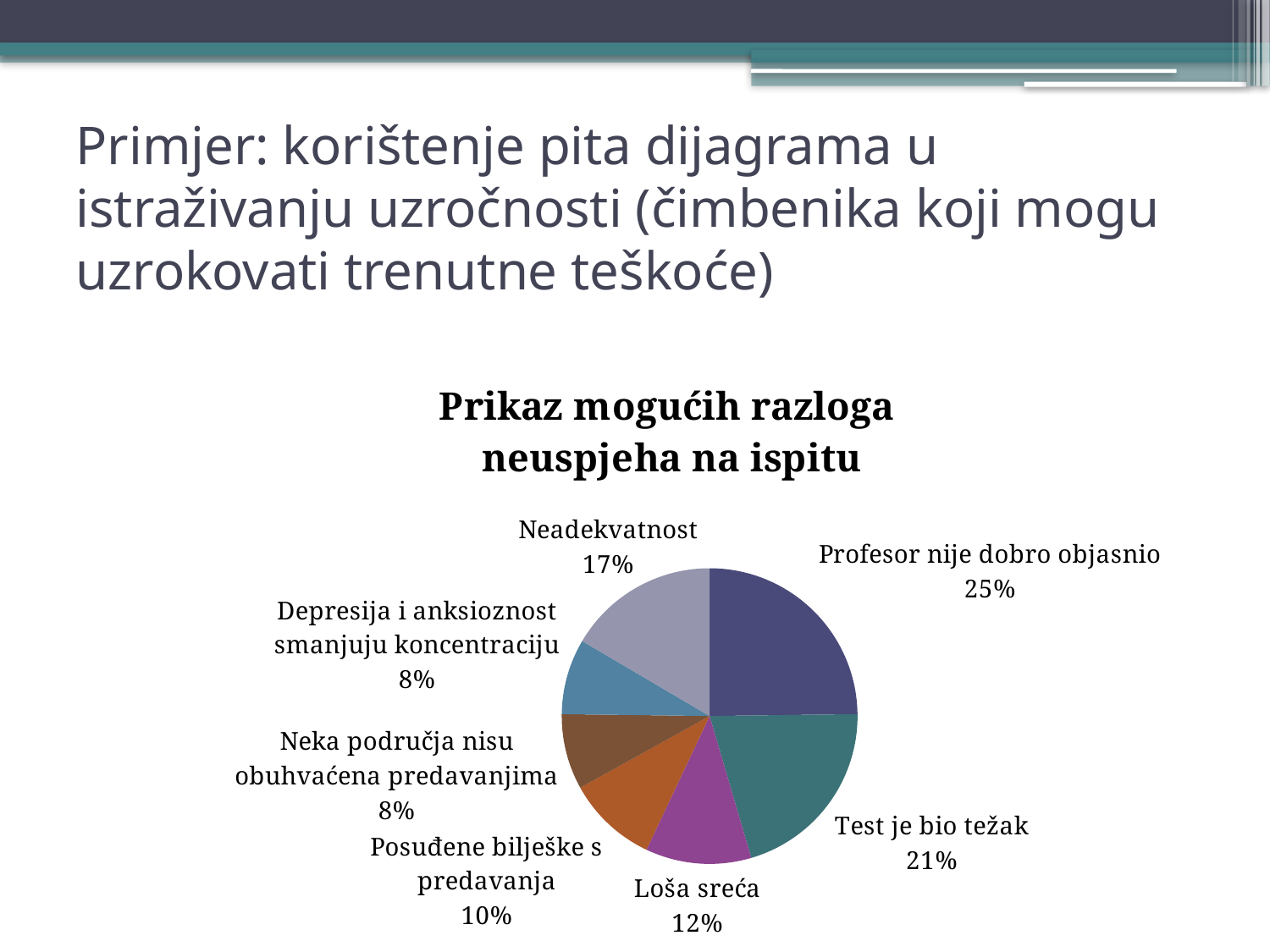
What is the value for "Posuđene bilješke s predavanja"? 10% Which category has the largest slice of the pie? Profesor nije dobro objasnio How many slices does the pie chart have? 7 What is the value for "Neadekvatnost"? 17% What is the title of the chart? Prikaz mogućih razloga neuspjeha na ispitu What is the value for "Test je bio težak"? 21% Which two categories share the smallest value of 8%? Depresija i anksioznost smanjuju koncentraciju; Neka područja nisu obuhvaćena predavanjima What kind of chart is shown on the slide? pie chart What is the value for "Loša sreća"? 12% What is the difference between "Profesor nije dobro objasnio" and "Test je bio težak"? 4% Which is larger, "Neadekvatnost" or "Loša sreća"? Neadekvatnost What share of the pie does "Profesor nije dobro objasnio" have? 25%